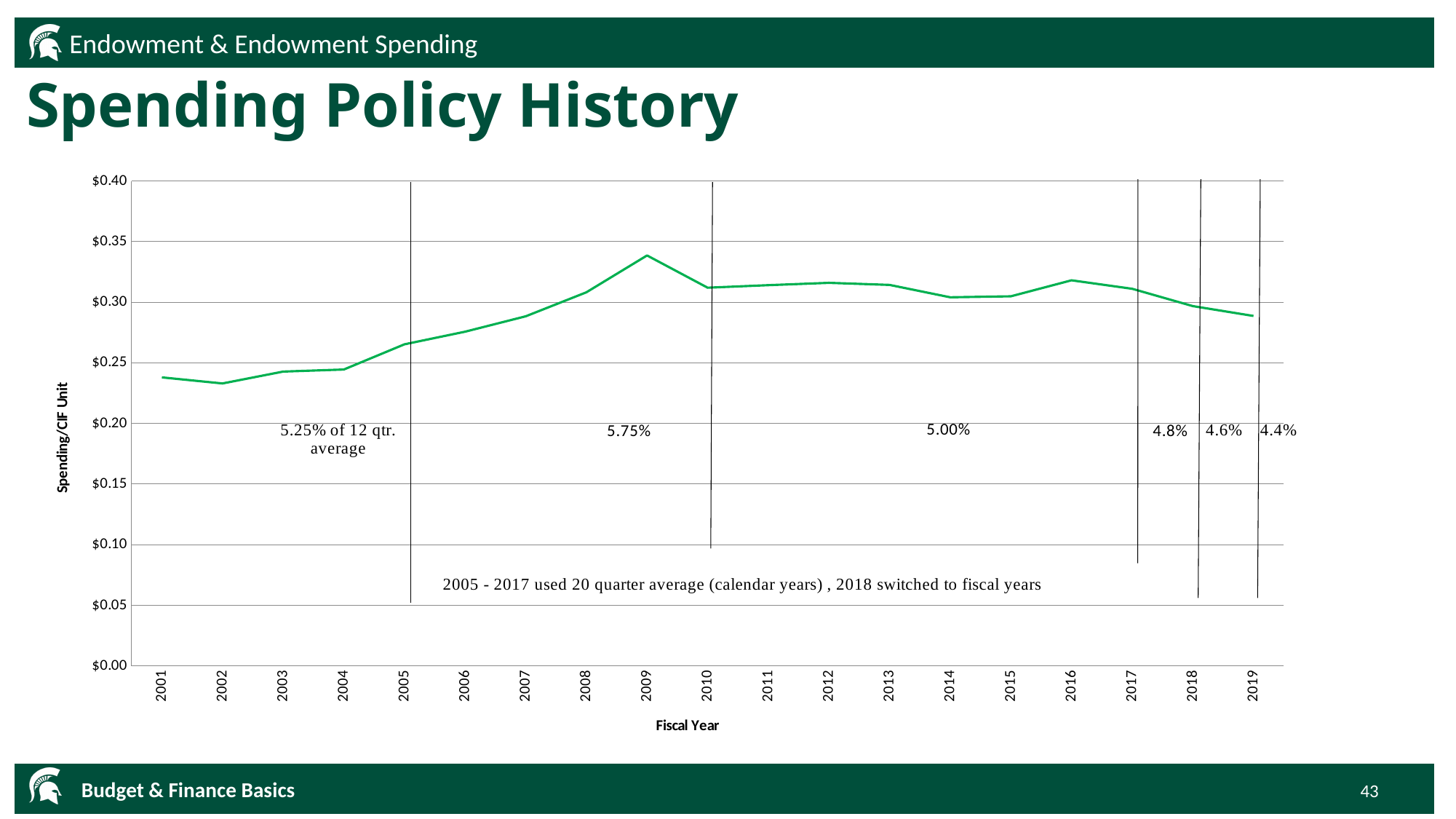
How many fiscal years are plotted on the x axis? 19 Is the value for 2012 greater or less than $0.30? greater Is the value for 2009 greater or less than $0.30? greater What kind of chart is shown on the slide? line chart Which fiscal year has the highest Spending/CIF Unit value? 2009 Which is larger, the value for 2005 or the value for 2001? 2005 What is the title of the y axis? Spending/CIF Unit Is the value for 2019 greater or less than $0.30? less Which is larger, the value for 2009 or the value for 2019? 2009 Do the values rise or fall from 2016 to 2019? fall Do the values rise or fall from 2001 to 2009? rise